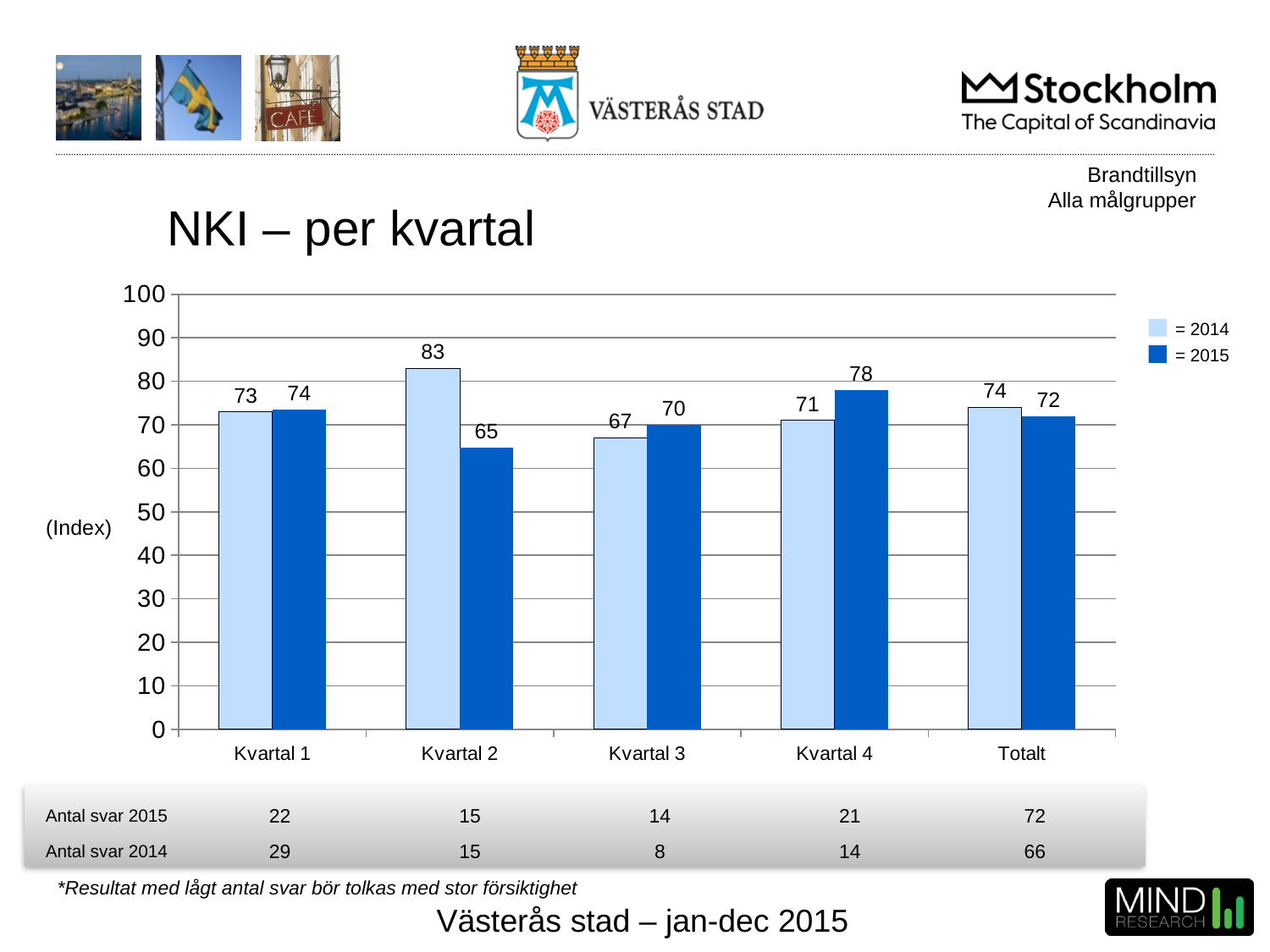
What is the title of the chart? NKI – per kvartal What is the 2014 NKI value for Kvartal 2? 83 What is the 2015 NKI value for Totalt? 72 Which is larger for Kvartal 3, the 2014 value or the 2015 value? 2015 Which category has the lowest 2015 value? Kvartal 2 How many series does the legend list? 2 Which colour represents 2015 in the legend? dark blue How many categories are shown on the x axis? 5 What kind of chart is shown on the slide? bar chart What is the 2015 NKI value for Kvartal 4? 78 What is the difference between the 2014 and 2015 values for Kvartal 2? 18 Which category has the highest 2014 value? Kvartal 2